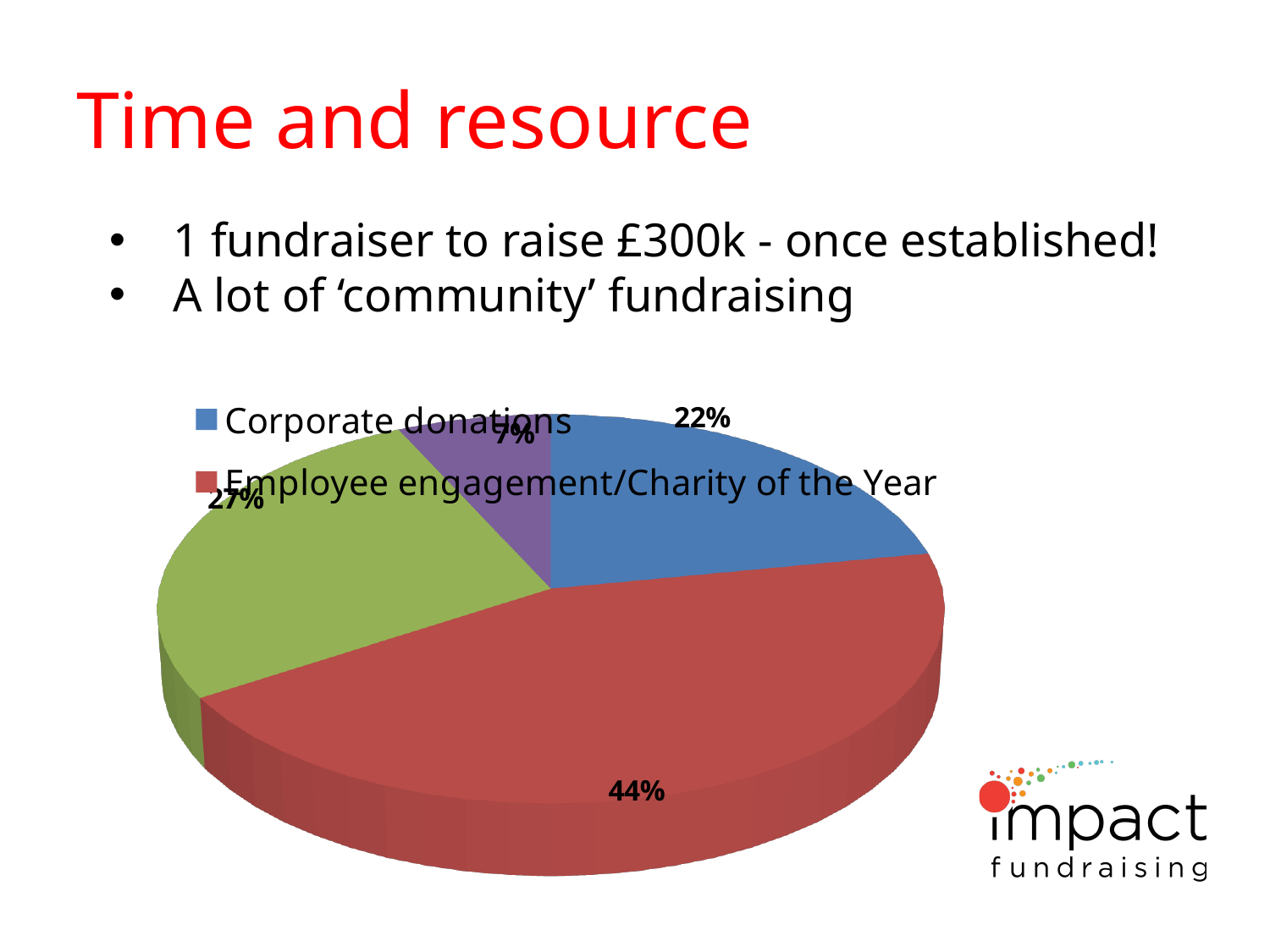
What percentage of the pie is Corporate donations? 22% What is the smallest percentage shown on the pie chart? 7% Which named category has the largest share of the pie? Employee engagement/Charity of the Year What colour is the Employee engagement/Charity of the Year slice? red Which is larger: the share for Corporate donations or the share for Employee engagement/Charity of the Year? Employee engagement/Charity of the Year By how many percentage points does Employee engagement/Charity of the Year exceed Corporate donations? 22 percentage points What colour is the Corporate donations slice? blue How many slices does the pie chart have? 4 What percentage of the pie is Employee engagement/Charity of the Year? 44% What is the largest percentage shown on the pie chart? 44% Is the share for Corporate donations greater or less than 25%? less What kind of chart is shown on the slide? pie chart